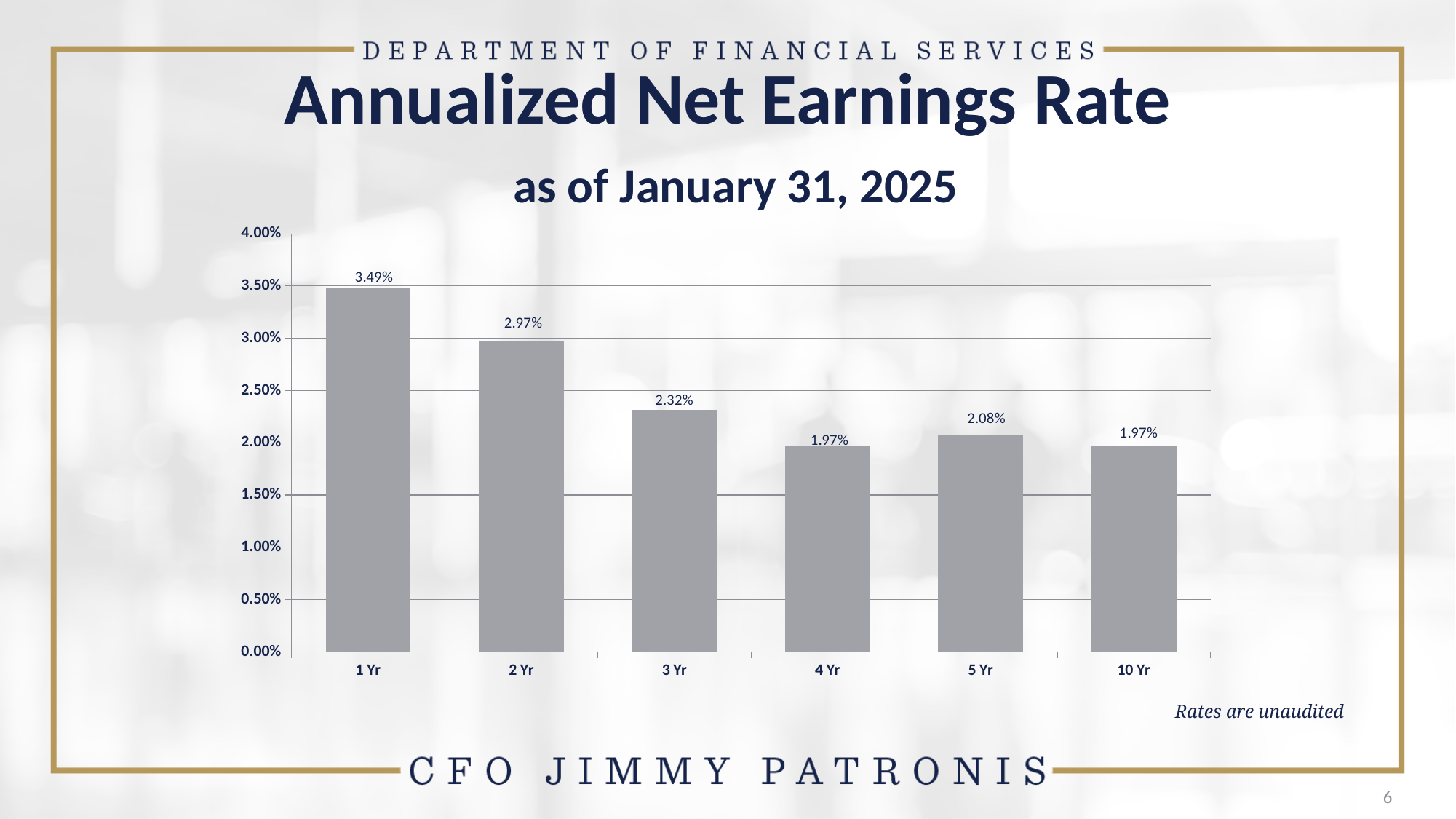
What is the annualized net earnings rate for 10 Yr? 1.97% Which is larger, the rate for 4 Yr or the rate for 5 Yr? 5 Yr What is the difference between the 3 Yr and 5 Yr rates? 0.24% What is the annualized net earnings rate for 3 Yr? 2.32% What is the difference between the 1 Yr and 2 Yr rates? 0.52% What is the annualized net earnings rate for 1 Yr? 3.49% What kind of chart is shown on the slide? bar chart Do the rates generally rise or fall from 1 Yr to 10 Yr? fall Is the value for 3 Yr greater or less than 2.50%? less How many periods are shown on the x axis? 6 What is the annualized net earnings rate for 5 Yr? 2.08% Which period has the highest annualized net earnings rate? 1 Yr